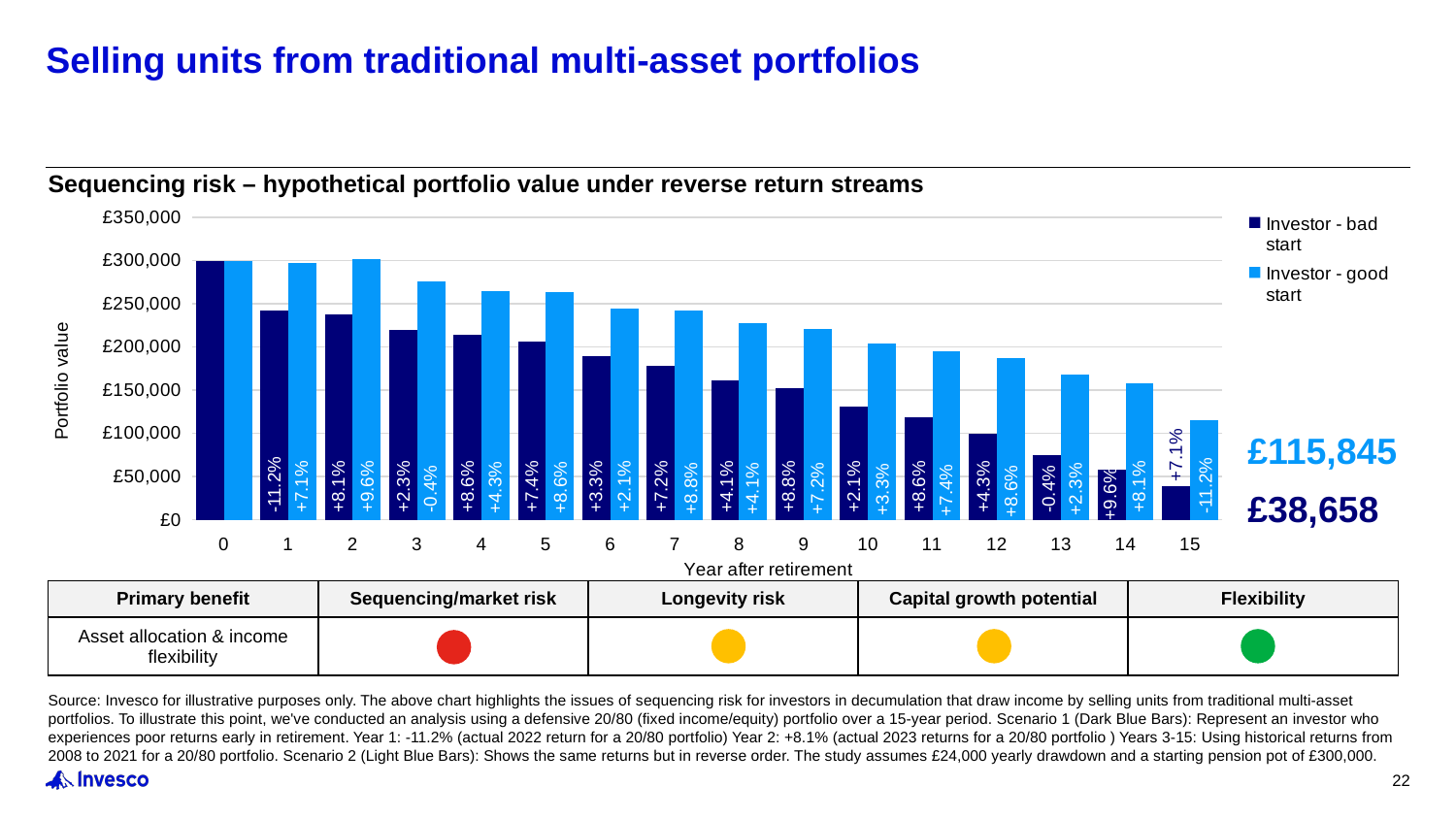
What is the label on the y axis of the chart? Portfolio value What return is labelled on the Investor - good start bar for year 2? +9.6% What is the final portfolio value shown for the Investor - bad start series? £38,658 At year 8, which series has the larger portfolio value, Investor - bad start or Investor - good start? Investor - good start What is the final portfolio value shown for the Investor - good start series? £115,845 Do the Investor - bad start portfolio values rise or fall as the year after retirement increases? Fall What return is labelled on the Investor - bad start bar for year 1? -11.2% What is the difference between the final portfolio values of the good start and bad start investors? £77,187 What kind of chart is shown on the slide? Bar chart How many years after retirement are shown on the x axis? 16 Is the portfolio value for Investor - bad start at year 10 greater or less than £150,000? less How many series does the legend list? 2